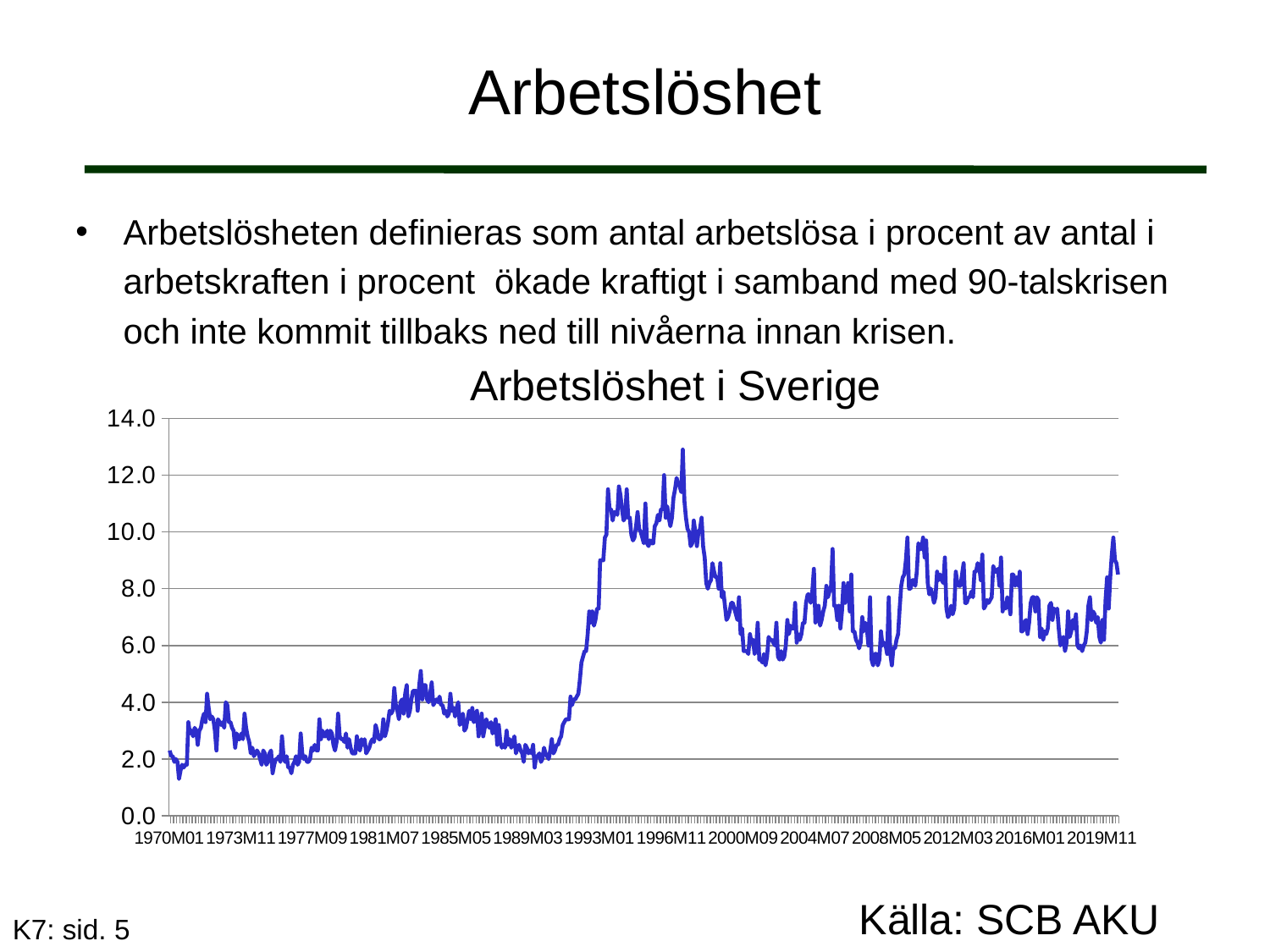
How many labelled tick marks are shown on the chart's horizontal axis? 14 What is the highest value shown on the chart's vertical axis? 14.0 What is the title of the chart? Arbetslöshet i Sverige Does the line rise or fall between 1989M03 and 1993M01? rise What kind of chart is shown on the slide? line chart Is the highest point of the line greater or less than 12.0? greater Is the value at 1970M01 greater or less than 4.0? less Is the value at 2012M03 greater or less than 6.0? greater Does the line rise or fall between 1996M11 and 2000M09? fall